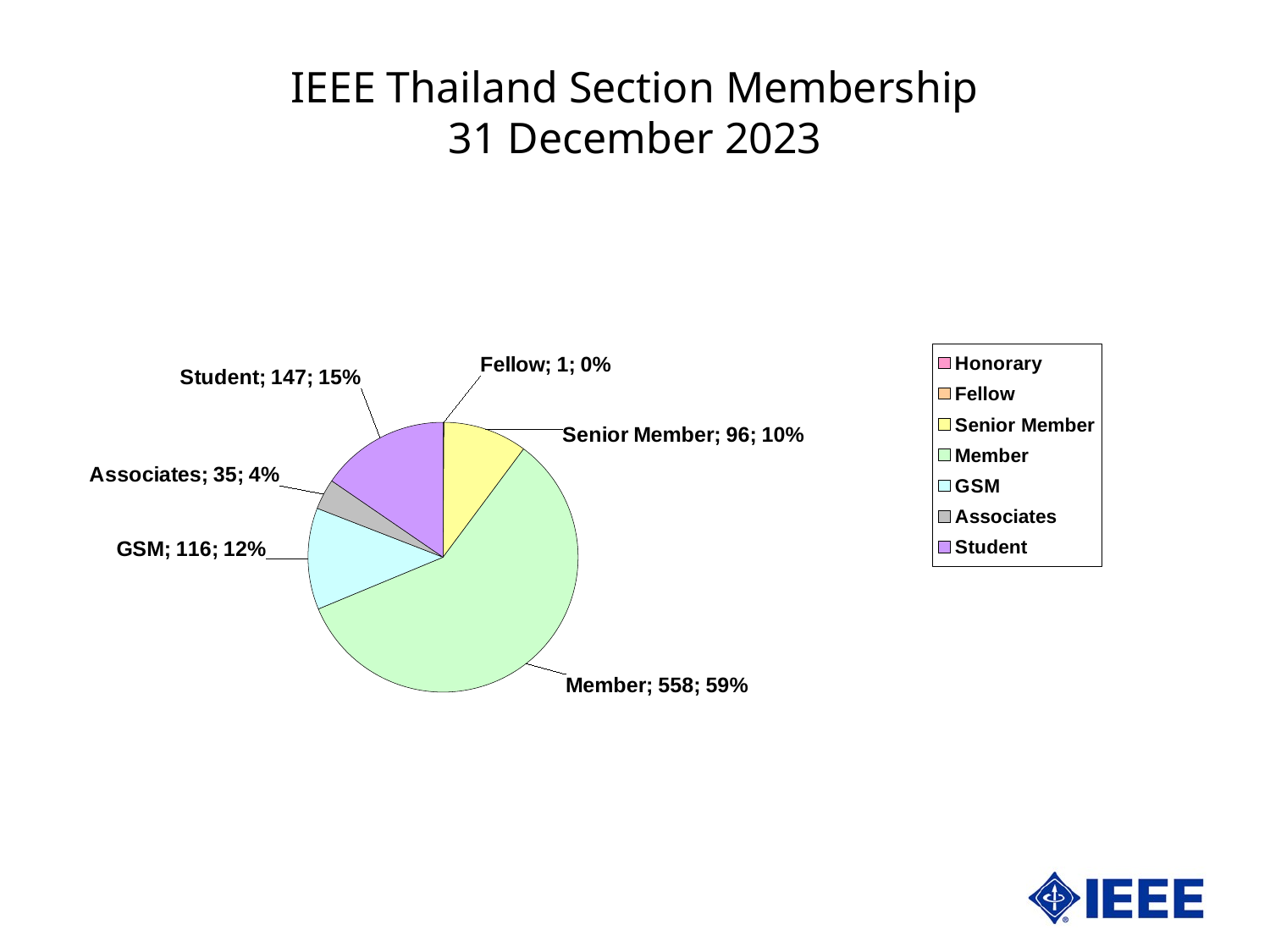
What type of chart is shown on the slide? Pie chart What is the value for GSM? 116 What is the title of the slide containing the chart? IEEE Thailand Section Membership 31 December 2023 What percentage share of the pie does the Student category have? 15% What is the value for Senior Member? 96 How many members are in the Member category? 558 What is the difference between the Student value and the GSM value? 31 Which is larger, the value for Associates or the value for Senior Member? Senior Member Which labelled category has the smallest slice of the pie? Fellow How many entries does the legend list? 7 What percentage share of the pie does the Member category have? 59% Which labelled category has the largest slice of the pie? Member